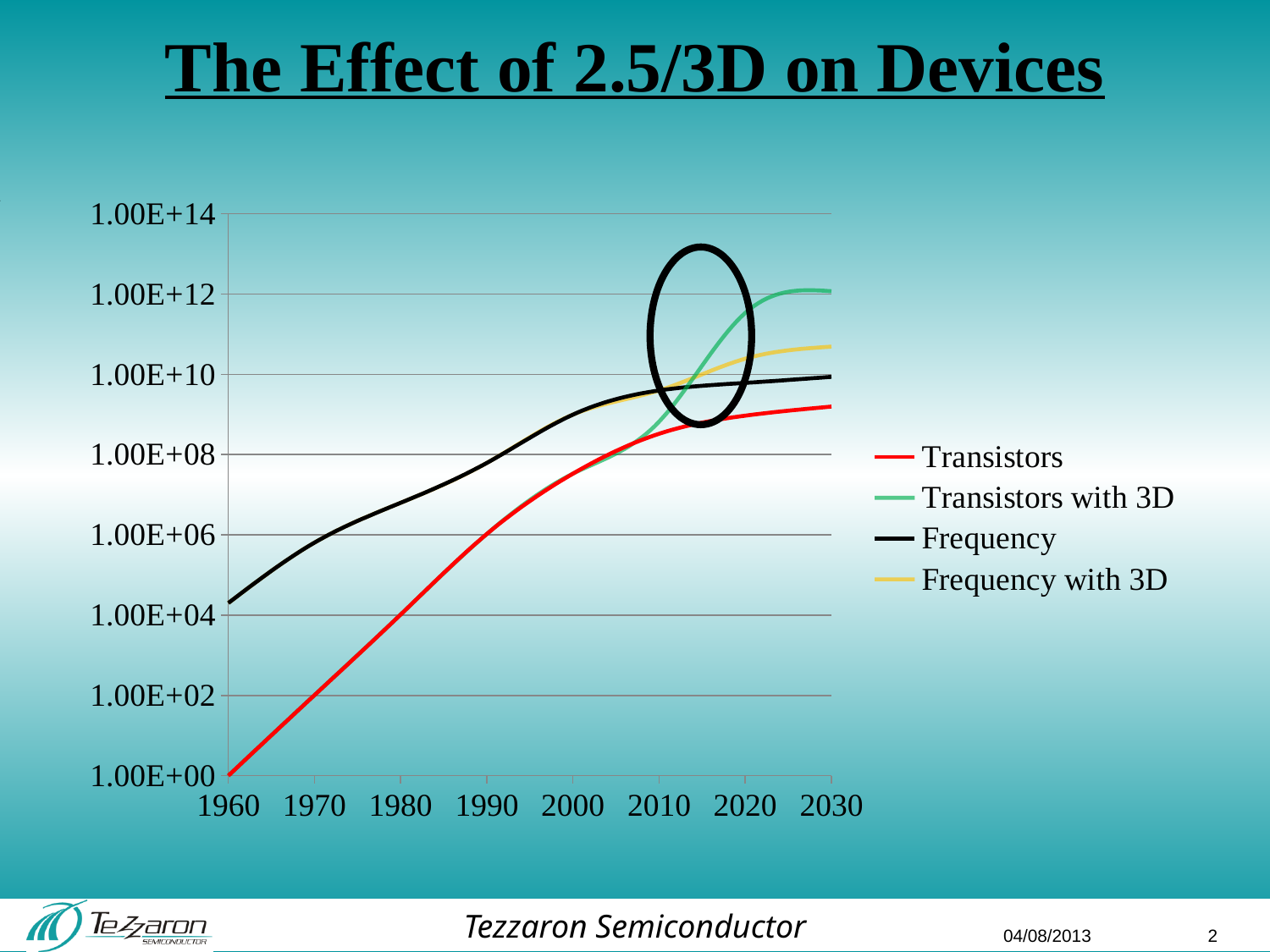
In 2030, which is higher: Transistors with 3D or Transistors? Transistors with 3D Is the value of Frequency in 1960 greater or less than 1.00E+06? less What kind of chart is shown on the slide? Line chart Which series is drawn in red in the chart? Transistors In 1960, which is higher: Frequency or Transistors? Frequency Is the value of Frequency with 3D in 2030 greater or less than 1.00E+12? less Is the value of Transistors in 2030 greater or less than 1.00E+10? less How many series does the chart legend list? 4 How many year labels are shown on the x axis of the chart? 8 What is the title of the slide containing the chart? The Effect of 2.5/3D on Devices Does the Transistors series rise or fall from 1960 to 2030? Rise